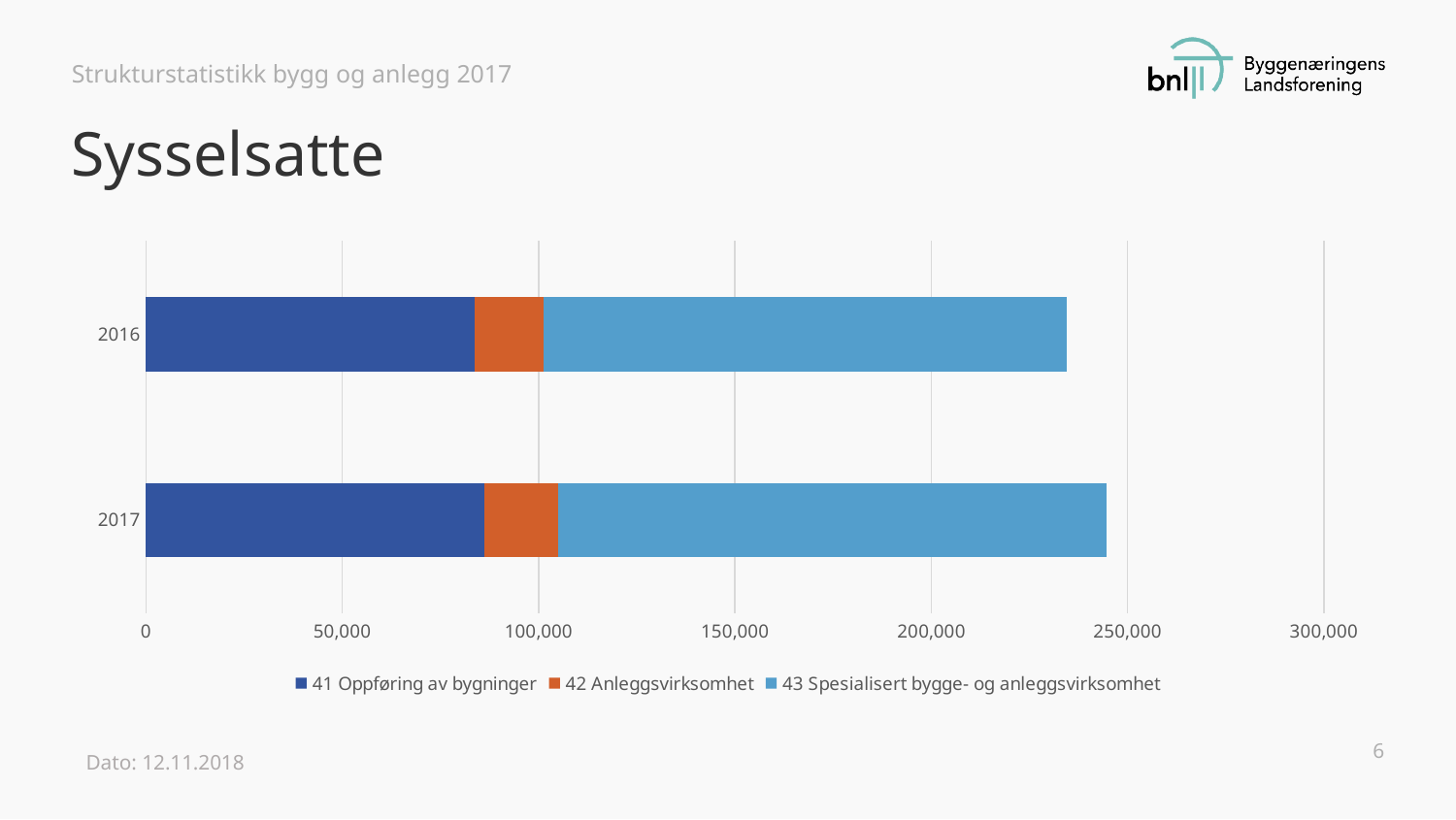
Which year has the larger total bar, 2016 or 2017? 2017 Is the total value of the 2017 bar greater or less than 200,000? greater Which series has the smallest segment in the 2017 bar? 42 Anleggsvirksomhet Is the total value of the 2016 bar greater or less than 250,000? less Which colour represents the series 42 Anleggsvirksomhet? Orange How many series does the legend list? 3 Is the value for 41 Oppføring av bygninger in 2017 greater or less than 100,000? less Does the total number of employed rise or fall from 2016 to 2017? Rise What is the title of the chart? Sysselsatte How many years (categories) are plotted on the chart? 2 What kind of chart is shown on the slide? Stacked bar chart